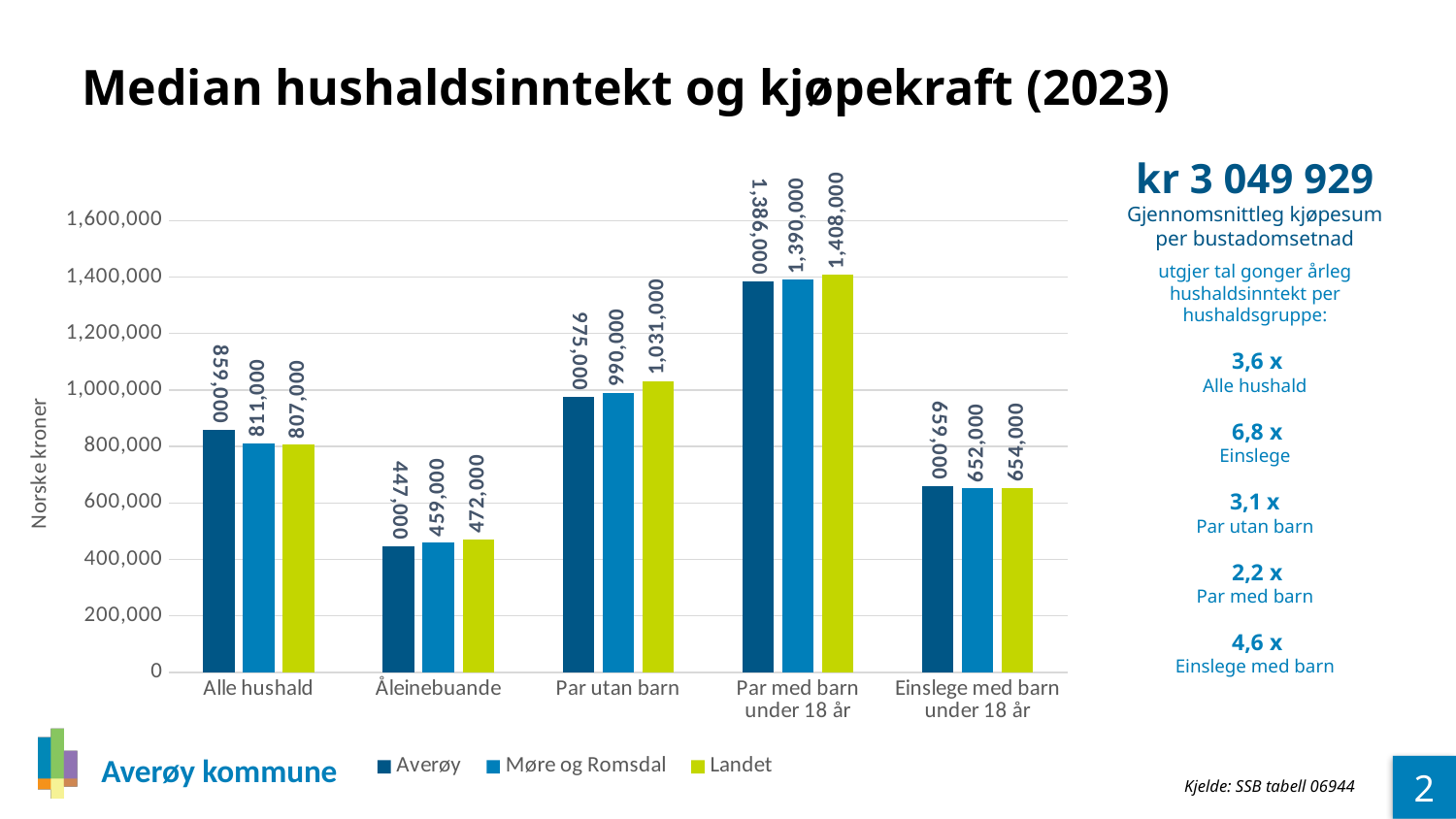
What is the label of the y axis? Norske kroner What is the difference between the Landet and Averøy values in the Par utan barn category? 56,000 How many categories are shown on the x axis? 5 What is the value for Landet in the Par med barn under 18 år category? 1,408,000 What kind of chart is shown on the slide? bar chart What is the value for Møre og Romsdal in the Åleinebuande category? 459,000 In the Alle hushald category, which is larger: the value for Averøy or the value for Landet? Averøy How many series does the legend list? 3 What is the value for Averøy in the Alle hushald category? 859,000 Is the value for Møre og Romsdal in the Einslege med barn under 18 år category greater or less than 800,000? less Which category has the lowest value for Landet? Åleinebuande Which category has the highest value for Averøy? Par med barn under 18 år